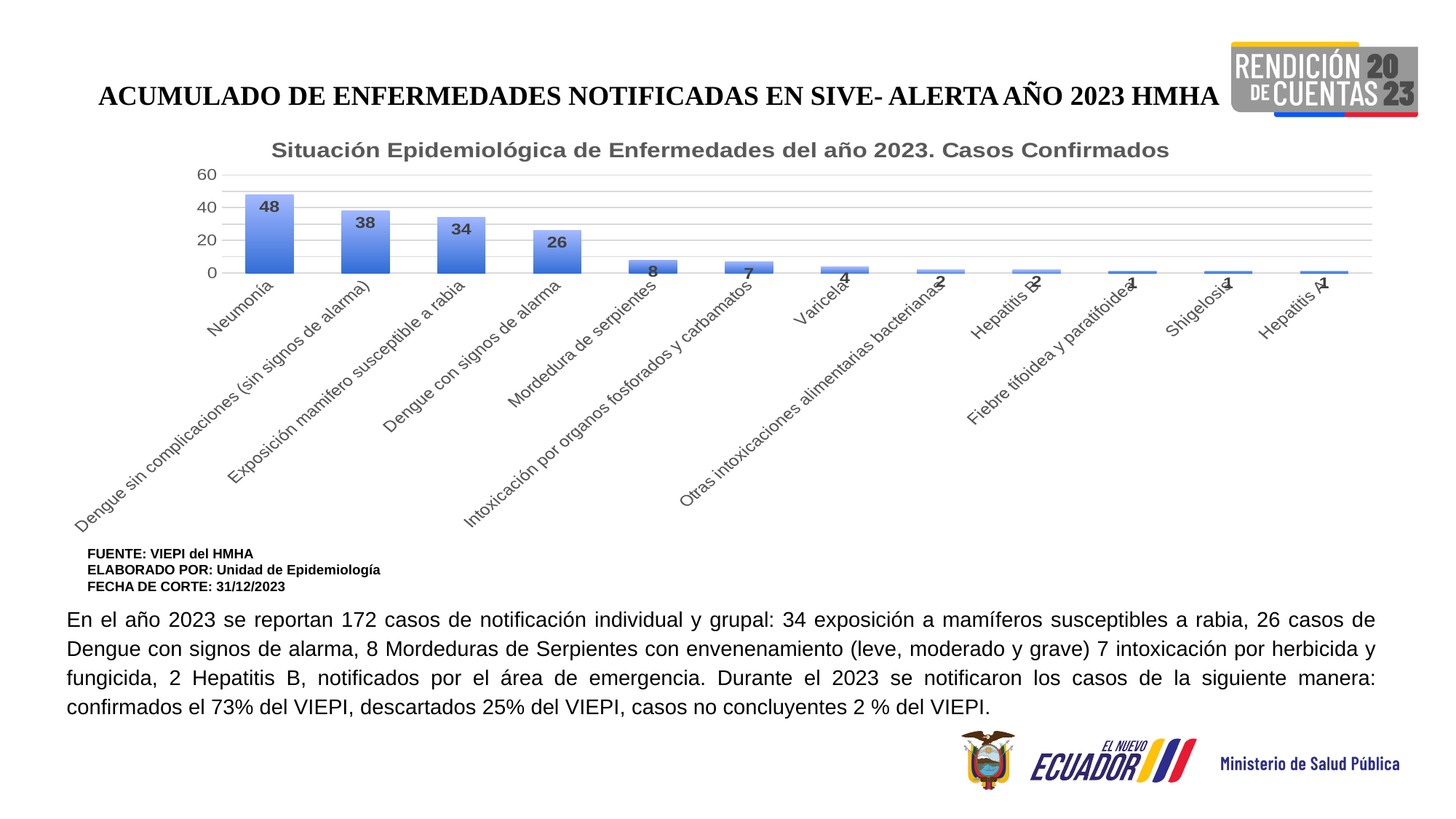
What type of chart is shown on the slide? Bar chart How many disease categories are shown in the chart? 12 What is the number of confirmed cases for Exposición mamífero susceptible a rabia? 34 What is the number of confirmed cases for Neumonía? 48 Which disease has the highest number of confirmed cases? Neumonía What is the title of the chart? Situación Epidemiológica de Enfermedades del año 2023. Casos Confirmados Do the values rise or fall from left to right along the x axis? Fall What is the number of confirmed cases for Dengue con signos de alarma? 26 What is the difference in confirmed cases between Neumonía and Dengue sin complicaciones (sin signos de alarma)? 10 Which has more confirmed cases, Exposición mamífero susceptible a rabia or Dengue con signos de alarma? Exposición mamífero susceptible a rabia Is the value for Dengue sin complicaciones (sin signos de alarma) greater or less than 20? greater What is the number of confirmed cases for Mordedura de serpientes? 8